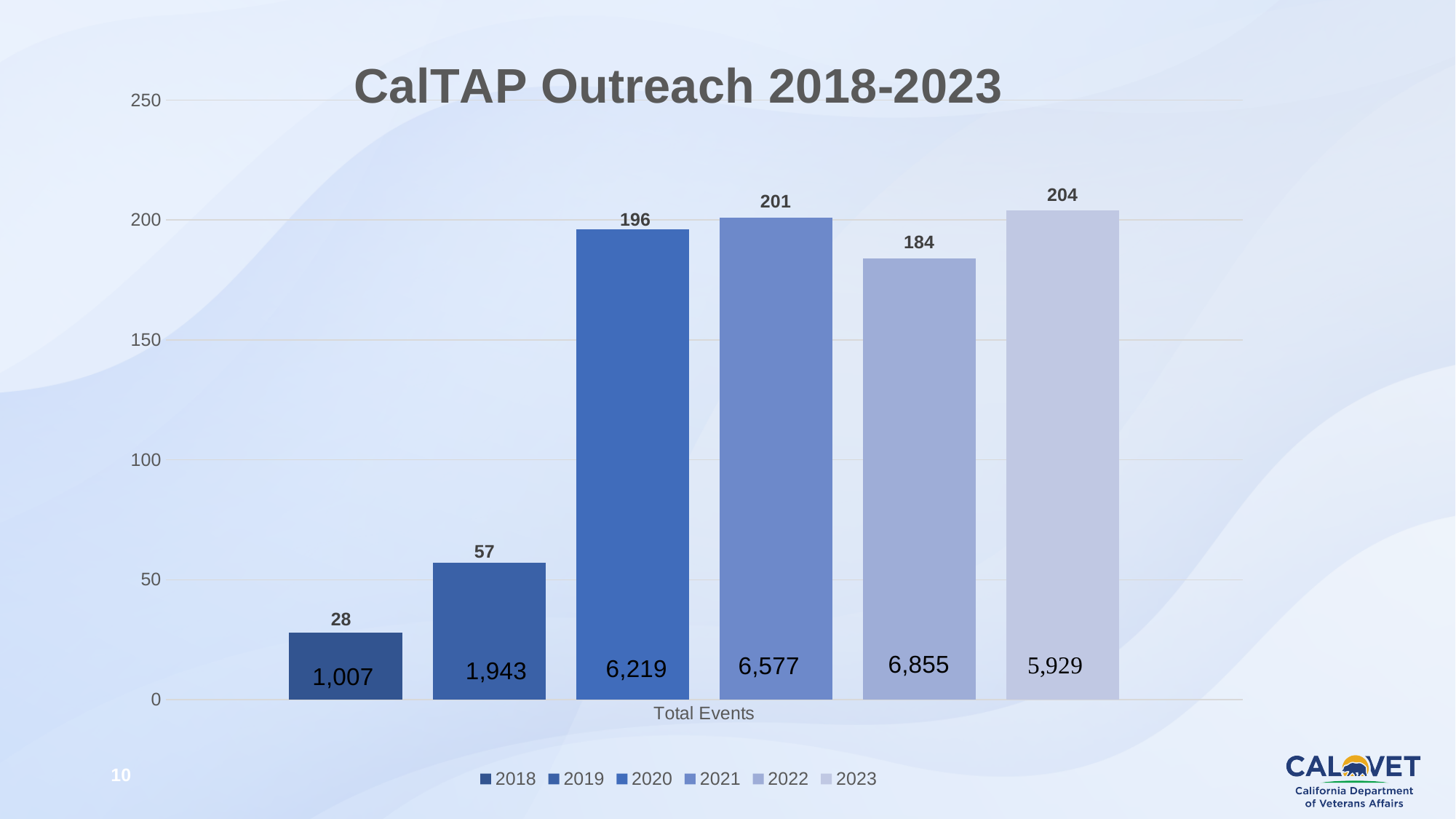
What is the label on the x axis beneath the bars? Total Events What is the value of the 2022 bar for Total Events? 184 What is the difference between the 2020 and 2019 Total Events values? 139 Which year has the highest Total Events value? 2023 What is the value of the 2021 bar for Total Events? 201 Which year has the lowest Total Events value? 2018 What type of chart is shown on the slide? bar chart Which is larger, the Total Events value for 2021 or for 2022? 2021 What is the value of the 2018 bar for Total Events? 28 How many series does the legend list? 6 What is the title of the chart? CalTAP Outreach 2018-2023 What number is printed inside the 2022 bar? 6,855